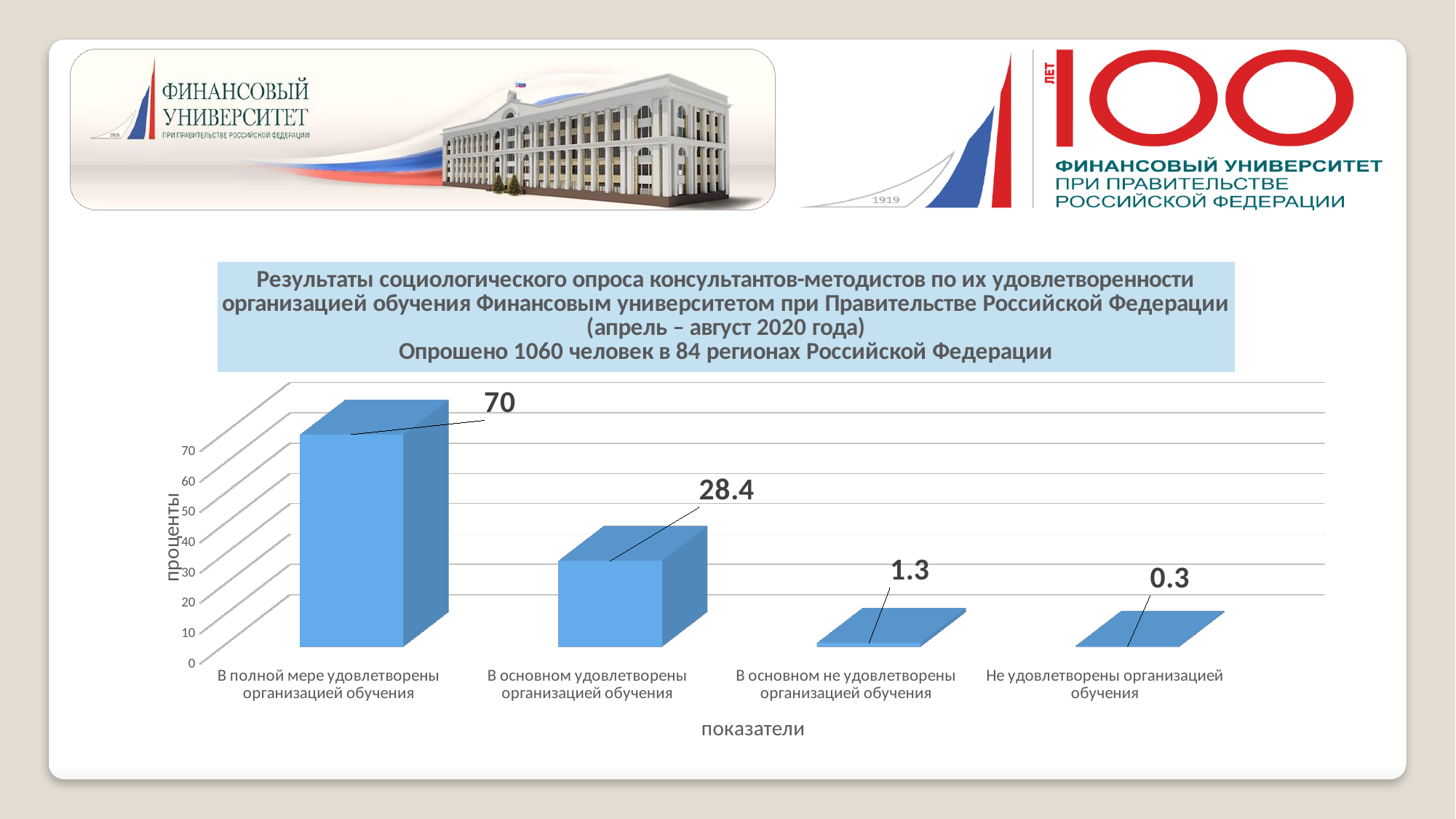
What is the value for "В полной мере удовлетворены организацией обучения"? 70 What is the value for "В основном не удовлетворены организацией обучения"? 1.3 What is the label of the vertical axis? проценты Do the values rise or fall from left to right along the x axis? fall Which category has the highest value? В полной мере удовлетворены организацией обучения What kind of chart is shown on the slide? bar chart How many categories are shown on the x axis? 4 Which category has the lowest value? Не удовлетворены организацией обучения What is the value for "Не удовлетворены организацией обучения"? 0.3 Which is larger: the value for "В основном не удовлетворены организацией обучения" or for "Не удовлетворены организацией обучения"? В основном не удовлетворены организацией обучения What is the difference between the values for "В полной мере удовлетворены организацией обучения" and "В основном удовлетворены организацией обучения"? 41.6 What is the value for "В основном удовлетворены организацией обучения"? 28.4